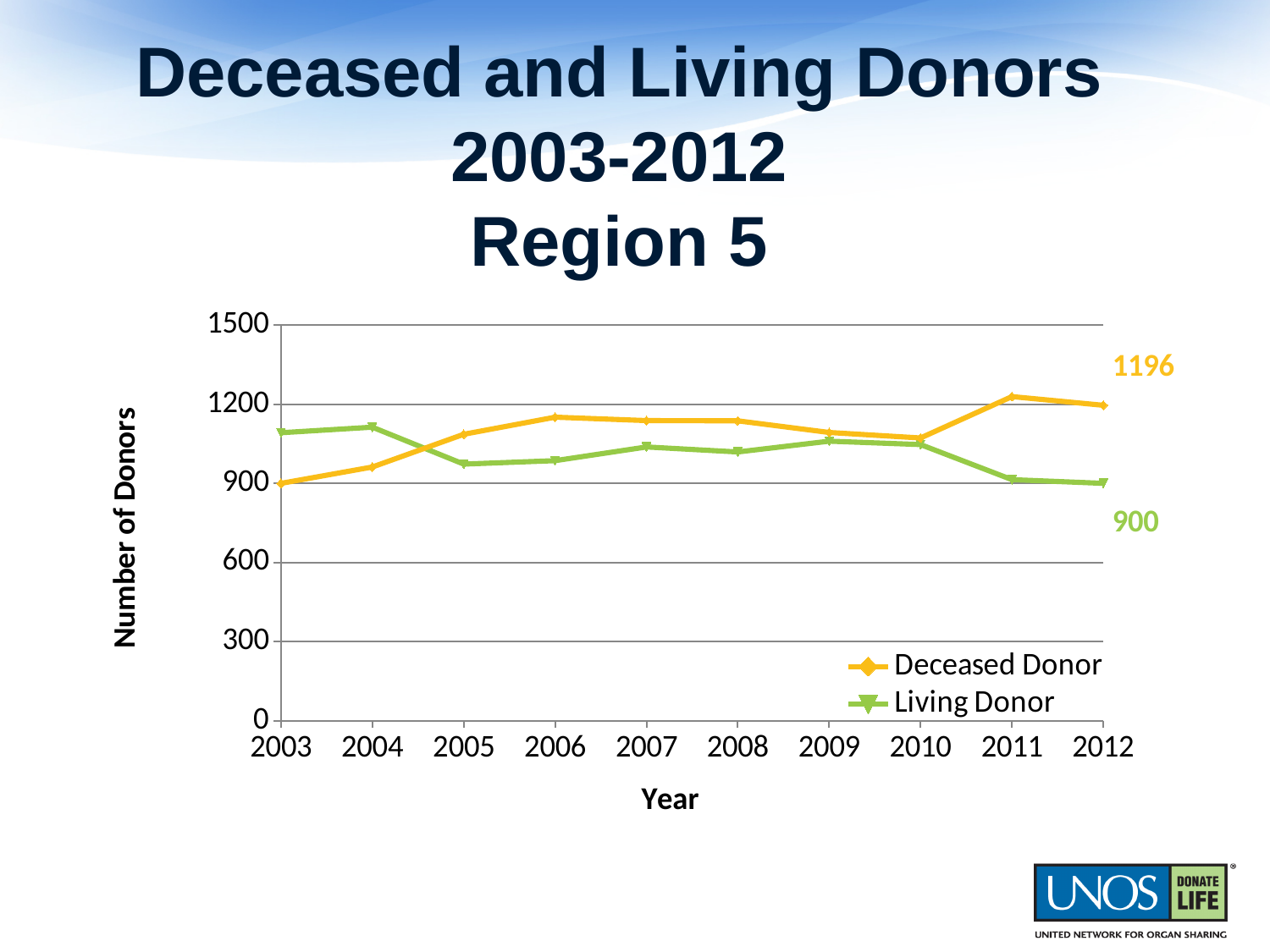
How many years are shown on the x axis? 10 What kind of chart is shown on the slide? Line chart In 2003, which series has the larger value, Deceased Donor or Living Donor? Living Donor What is the difference between the Deceased Donor and Living Donor values in 2012? 296 What is the title of the y axis? Number of Donors How many series does the legend list? 2 What is the value for Living Donor in 2012? 900 Is the value for Deceased Donor in 2006 greater or less than 900? greater What is the value for Deceased Donor in 2012? 1196 Is the value for Living Donor in 2005 greater or less than 1200? less In 2012, which series has the larger value, Deceased Donor or Living Donor? Deceased Donor In which year is the Deceased Donor value highest? 2011